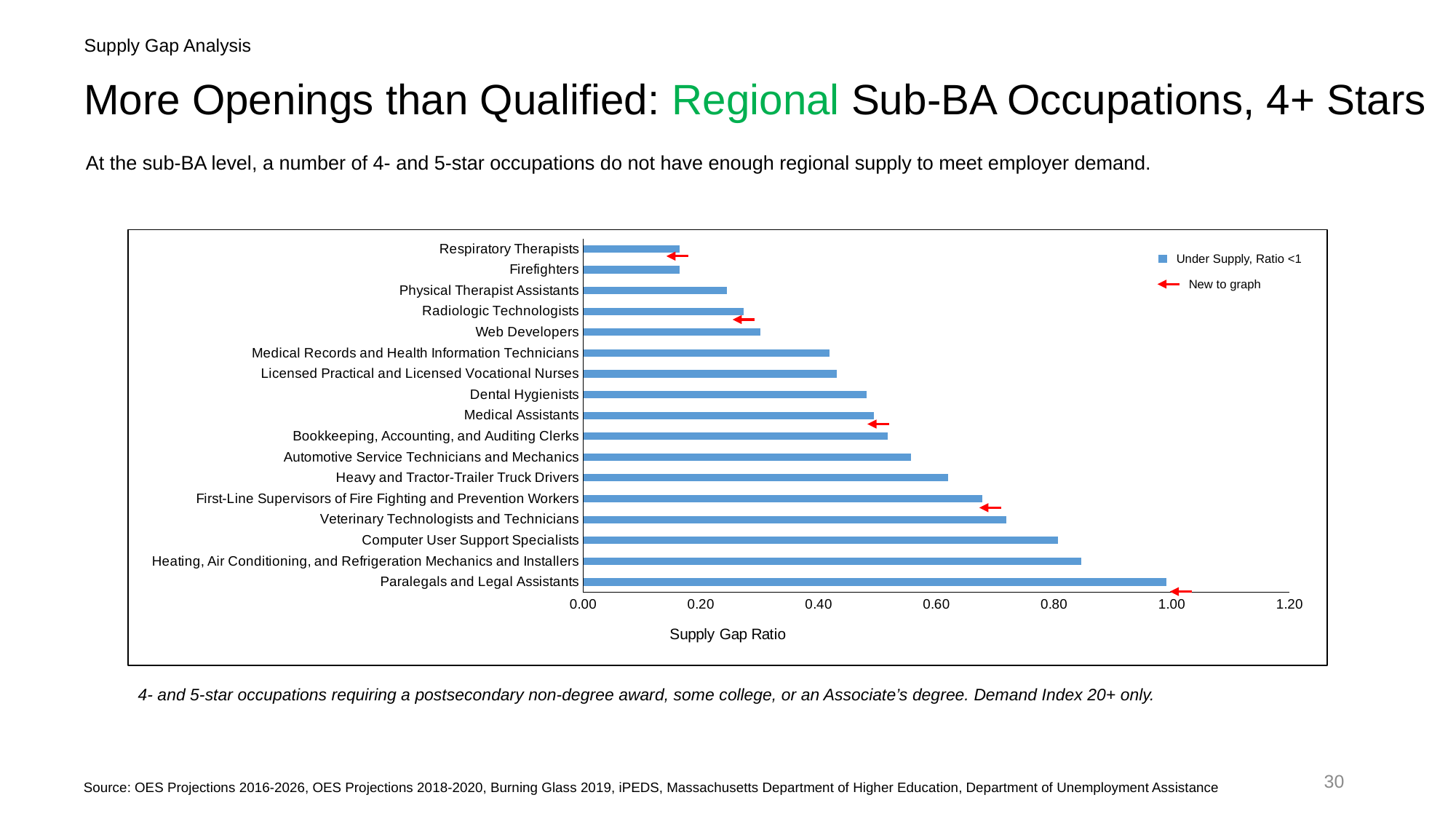
Which occupation has the highest Supply Gap Ratio in the chart? Paralegals and Legal Assistants Is the Supply Gap Ratio for Web Developers greater or less than 0.20? greater What is the title of the horizontal axis of the chart? Supply Gap Ratio Is the Supply Gap Ratio for Dental Hygienists greater or less than 0.60? less What type of chart is shown on the slide? Bar chart Is the Supply Gap Ratio for Veterinary Technologists and Technicians greater or less than 0.60? greater How many occupations are plotted in the chart? 17 According to the legend, what does a red arrow next to a bar indicate? New to graph Which has a larger Supply Gap Ratio: Dental Hygienists or Physical Therapist Assistants? Dental Hygienists Which has a larger Supply Gap Ratio: Heating, Air Conditioning, and Refrigeration Mechanics and Installers or Web Developers? Heating, Air Conditioning, and Refrigeration Mechanics and Installers